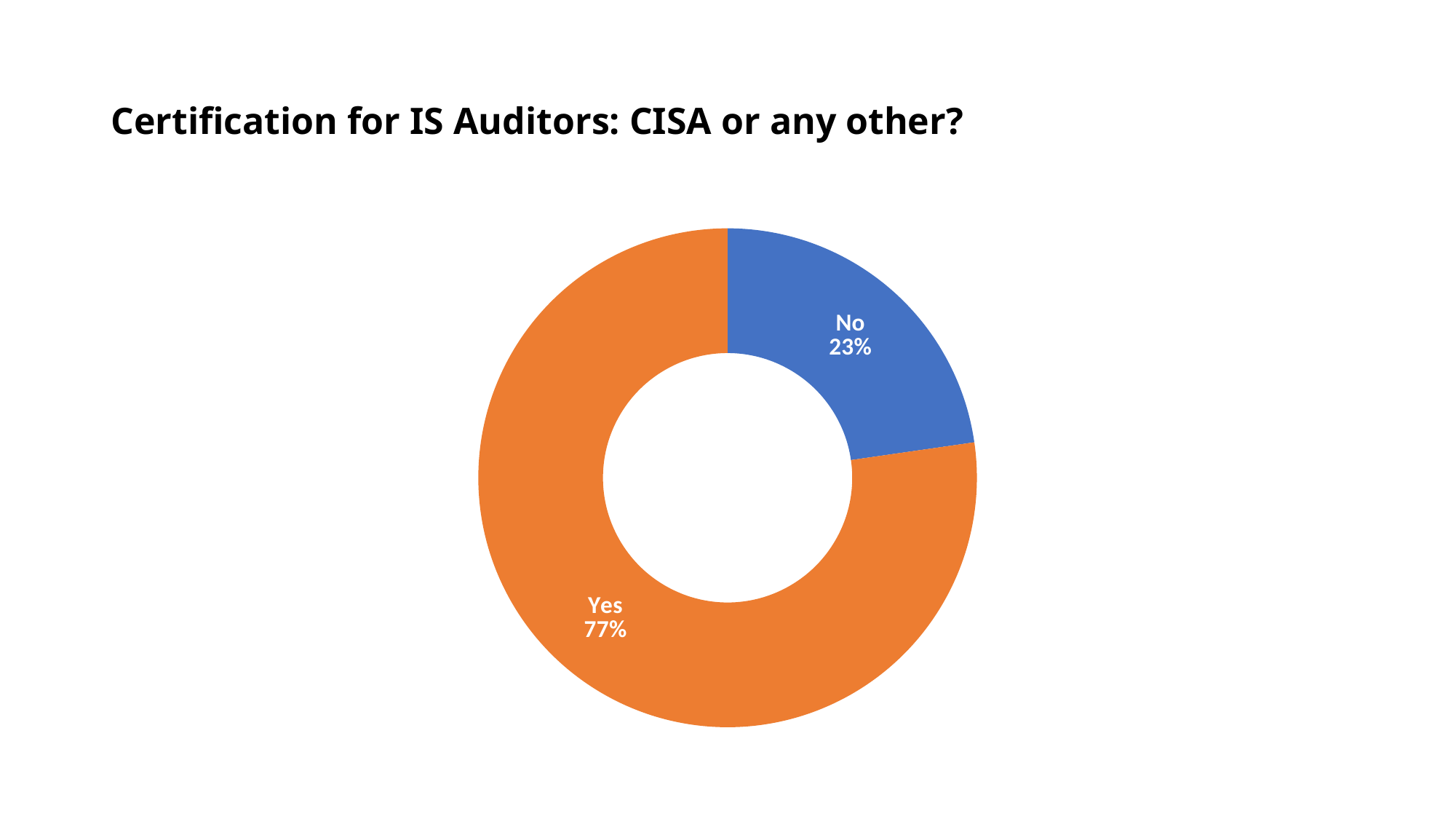
Which category has the largest share of the chart? Yes Which category has the smallest share of the chart? No What is the title of the chart? Certification for IS Auditors: CISA or any other? What kind of chart is shown on the slide? Doughnut (pie) chart What percentage of respondents answered "No"? 23% Which is larger, the share for "Yes" or the share for "No"? Yes What is the difference in percentage points between the "Yes" and "No" shares? 54 What share of the chart does the "No" slice represent? 23% What colour is the "Yes" slice? Orange What percentage of respondents answered "Yes"? 77% How many categories are shown in the chart? 2